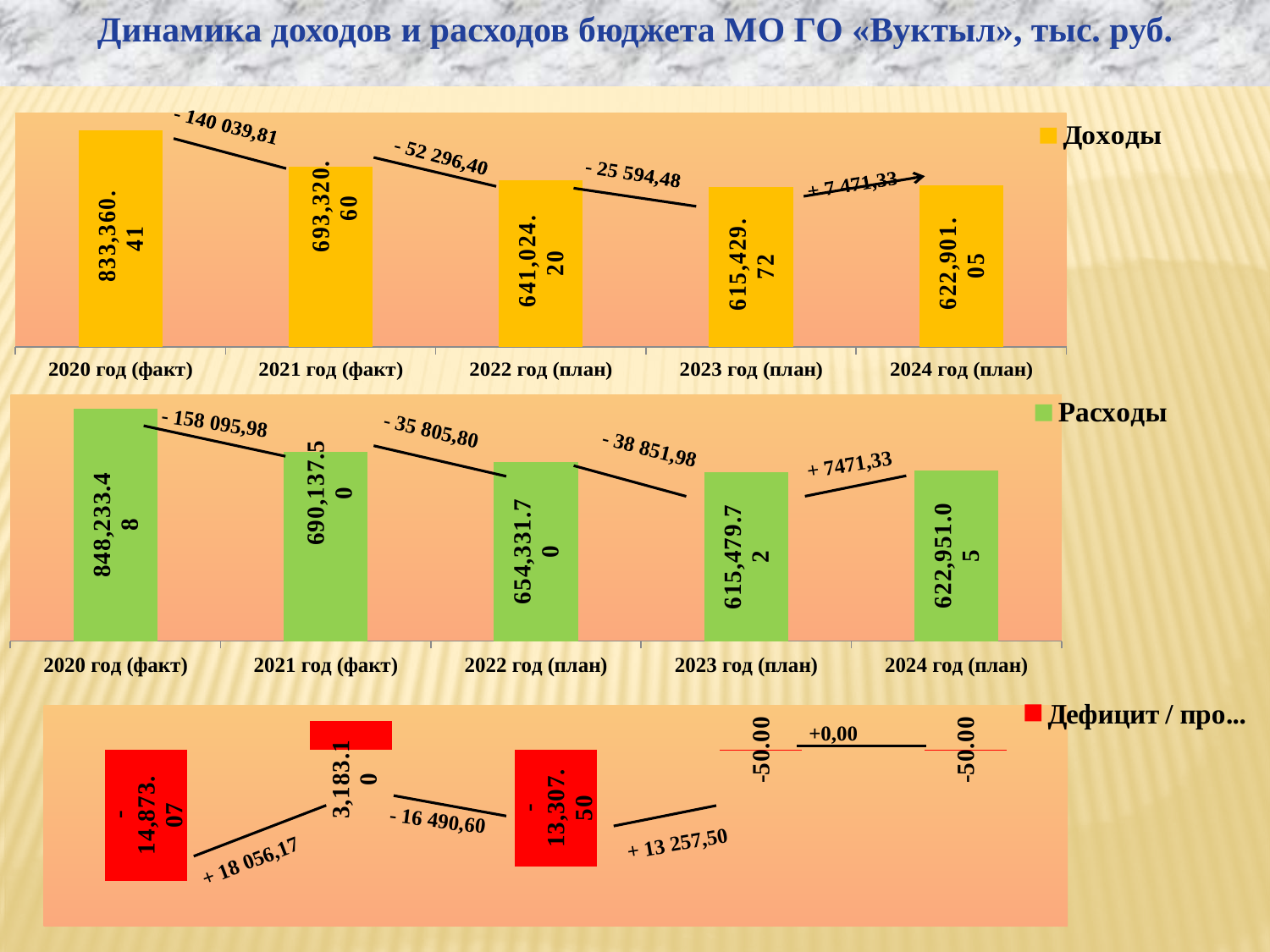
On the Расходы chart, which year has the highest value? 2020 год (факт) On the Доходы chart, what is the value for 2024 год (план)? 622,901.05 On the Доходы chart, what is the difference between the 2020 год (факт) and 2021 год (факт) values? 140,039.81 On the Расходы chart, what is the value for 2022 год (план)? 654,331.70 On the Доходы chart, how many years are shown on the x axis? 5 What type of chart is the Доходы chart? bar chart On the Доходы chart, which year has the lowest value? 2023 год (план) On the Дефицит / профицит chart (bottom), what is the value for the third bar (2022)? -13,307.50 On the Дефицит / профицит chart (bottom), what is the value of the only positive bar (2021)? 3,183.10 On the Расходы chart, which is larger: the value for 2023 год (план) or 2024 год (план)? 2024 год (план) On the Доходы chart, what is the value for 2020 год (факт)? 833,360.41 On the Расходы chart, do the values rise or fall from 2020 to 2023? fall